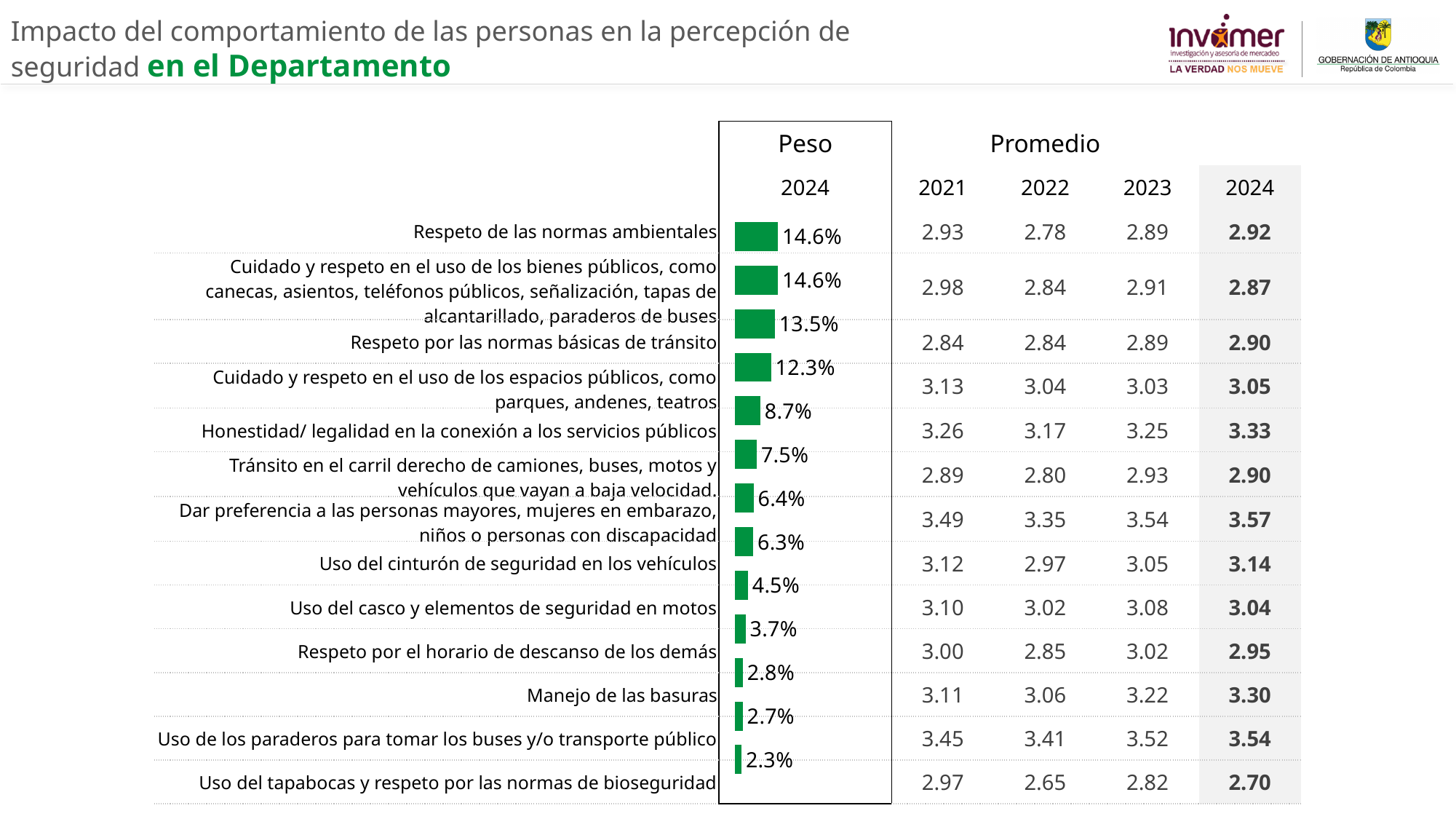
In the "Peso 2024" bar chart, what is the value for "Respeto de las normas ambientales"? 14.6% What colour are the bars in the "Peso 2024" bar chart? green In the "Peso 2024" bar chart, what is the value for "Uso del tapabocas y respeto por las normas de bioseguridad"? 2.3% In the "Peso 2024" bar chart, what is the difference between the values for "Respeto de las normas ambientales" and "Uso del tapabocas y respeto por las normas de bioseguridad"? 12.3% What kind of chart is shown under the "Peso" heading? bar chart How many categories (bars) does the "Peso 2024" bar chart show? 13 In the "Peso 2024" bar chart, what is the value for "Honestidad/ legalidad en la conexión a los servicios públicos"? 8.7% In the "Peso 2024" bar chart, what is the value for "Manejo de las basuras"? 2.8% Which category has the lowest value in the "Peso 2024" bar chart? Uso del tapabocas y respeto por las normas de bioseguridad In the "Peso 2024" bar chart, which is larger: the value for "Respeto por las normas básicas de tránsito" or for "Honestidad/ legalidad en la conexión a los servicios públicos"? Respeto por las normas básicas de tránsito In the "Peso 2024" bar chart, what is the difference between the values for "Manejo de las basuras" and "Uso de los paraderos para tomar los buses y/o transporte público"? 0.1% In the "Peso 2024" bar chart, what is the value for "Uso del casco y elementos de seguridad en motos"? 4.5%